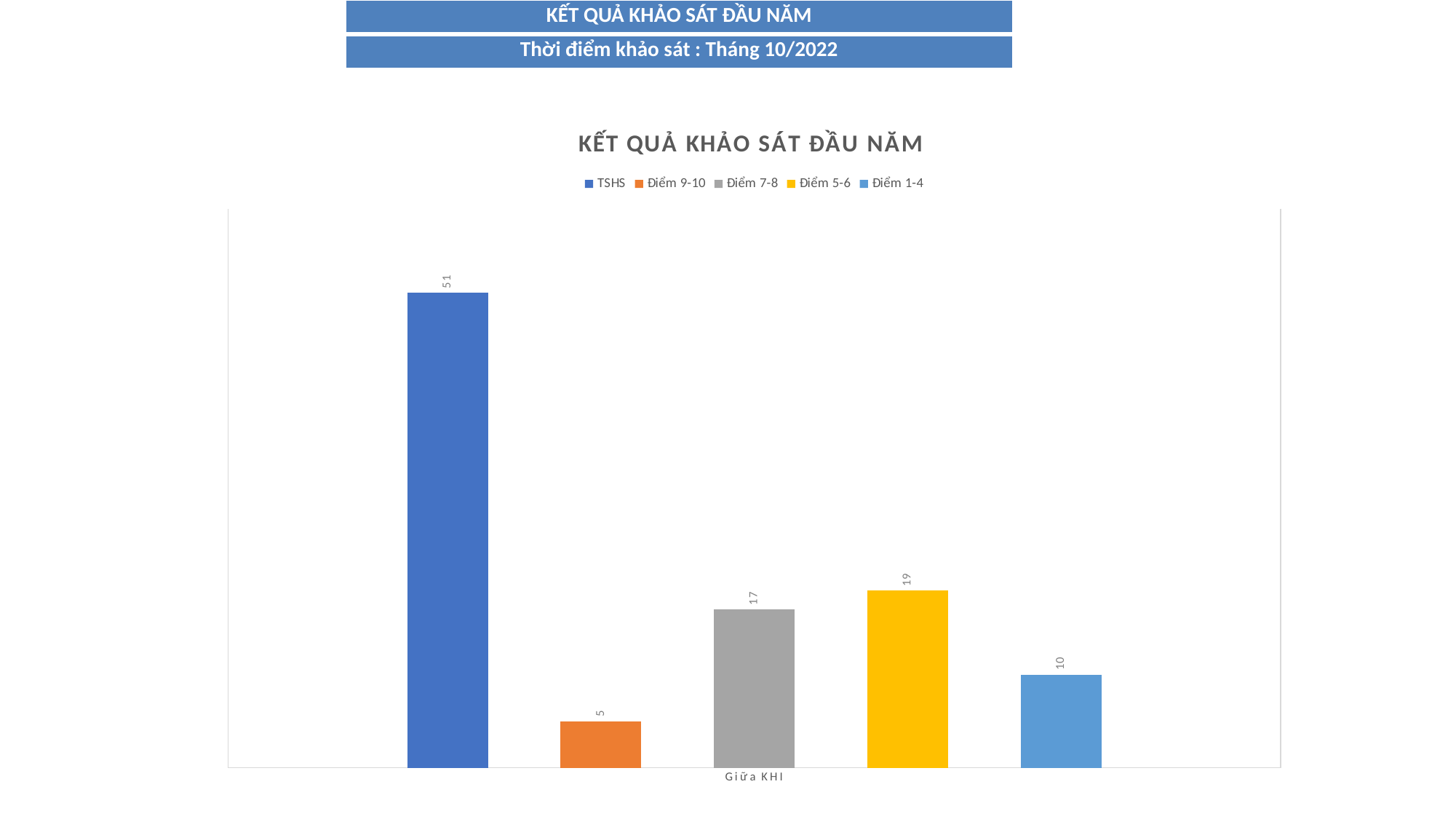
What kind of chart is shown on the slide? Bar chart What is the value for Điểm 1-4? 10 How many series does the legend list? 5 What is the value for Điểm 7-8? 17 Which is larger, the value for Điểm 7-8 or the value for Điểm 1-4? Điểm 7-8 What is the difference between the values for Điểm 5-6 and Điểm 7-8? 2 What is the value for Điểm 5-6? 19 Which series has the lowest value? Điểm 9-10 Which series has the highest value? TSHS What is the value for Điểm 9-10? 5 What is the title of the chart? KẾT QUẢ KHẢO SÁT ĐẦU NĂM What is the value of the TSHS bar? 51